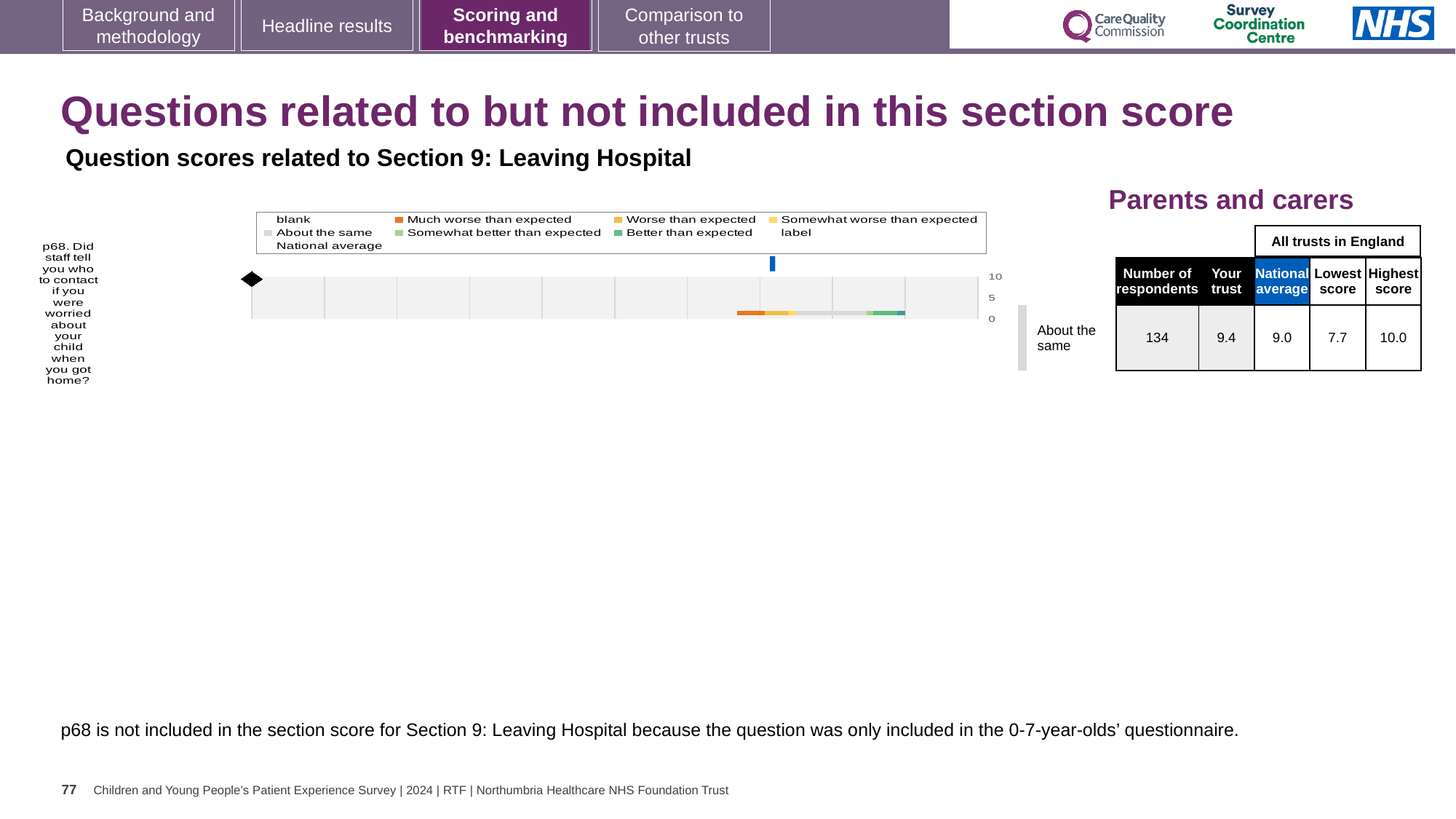
What is the difference between the 'Your trust' score and the national average for p68? 0.4 According to the table beside the chart, what is the highest score among all trusts in England for p68? 10.0 What is the highest value shown on the chart's numeric axis? 10 Which benchmark category label is shown next to the chart for the trust's result on p68? About the same According to the table beside the chart, what is the national average score for p68? 9.0 What is the difference between the highest score and the lowest score among all trusts in England for p68? 2.3 According to the table beside the chart, what is the lowest score among all trusts in England for p68? 7.7 What kind of chart is shown on the slide for question p68? bar chart Which is larger for p68: the 'Your trust' score or the national average? Your trust How many respondents answered question p68, according to the table beside the chart? 134 How many survey questions are plotted in the chart on this slide? 1 According to the table beside the chart, what is the 'Your trust' score for p68? 9.4